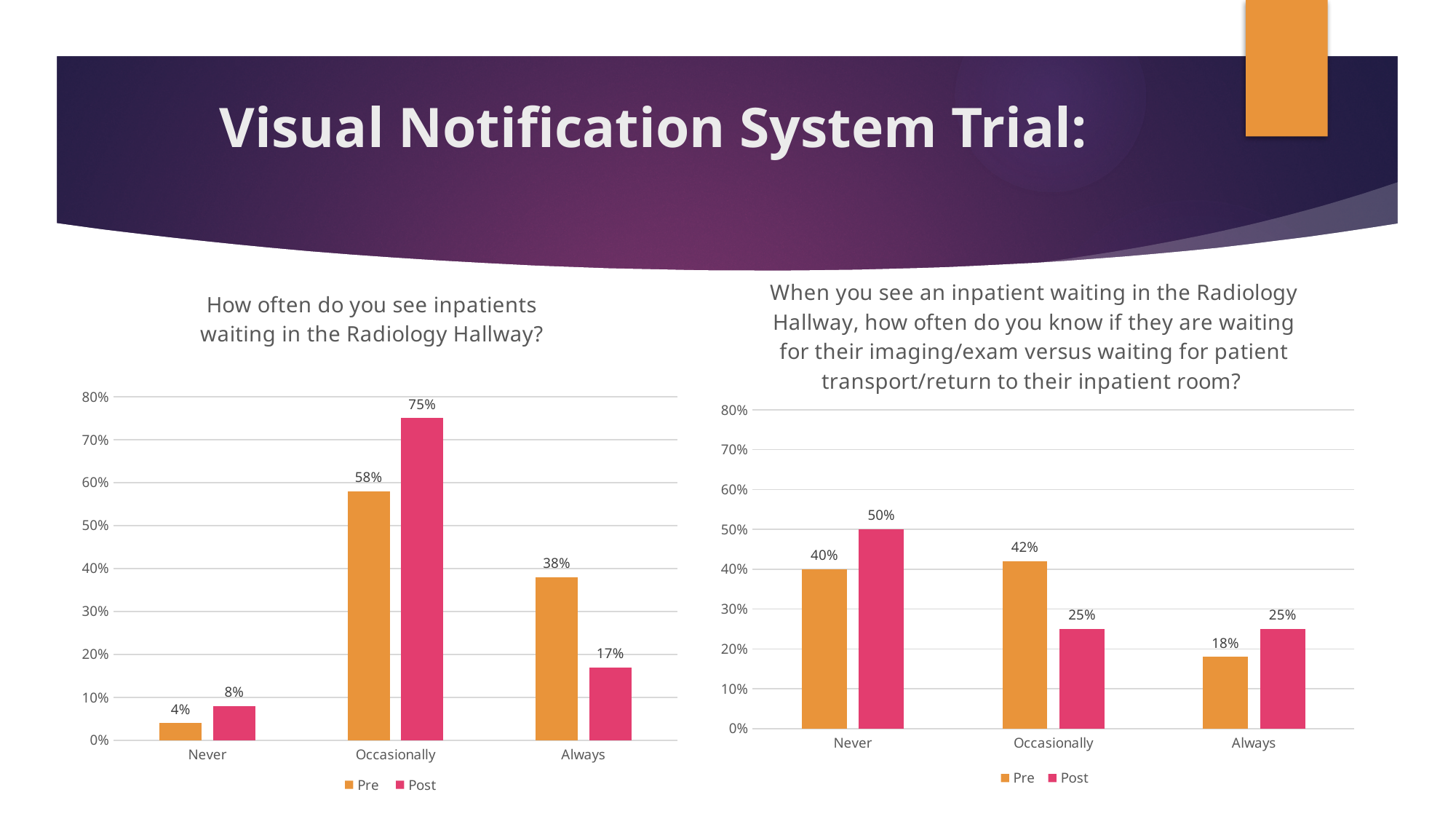
In the left chart (How often do you see inpatients waiting in the Radiology Hallway?), which category has the lowest Pre value? Never In the left chart (How often do you see inpatients waiting in the Radiology Hallway?), what is the difference between the Pre and Post values for Always? 21% What kind of chart is the right chart (When you see an inpatient waiting in the Radiology Hallway...)? Bar chart In the left chart (How often do you see inpatients waiting in the Radiology Hallway?), is the Pre value for Never greater or less than 10%? less In the left chart (How often do you see inpatients waiting in the Radiology Hallway?), what is the Post value for Occasionally? 75% In the right chart (When you see an inpatient waiting in the Radiology Hallway...), what is the difference between the Post and Pre values for Always? 7% How many series does the legend of the left chart list? 2 In the right chart (When you see an inpatient waiting in the Radiology Hallway...), which category has the highest Post value? Never In the right chart (When you see an inpatient waiting in the Radiology Hallway...), what is the Pre value for Occasionally? 42% In the right chart (When you see an inpatient waiting in the Radiology Hallway...), which is larger for Occasionally, the Pre value or the Post value? Pre In the left chart (How often do you see inpatients waiting in the Radiology Hallway?), what is the Pre value for Always? 38% In the right chart (When you see an inpatient waiting in the Radiology Hallway...), what is the Post value for Never? 50%